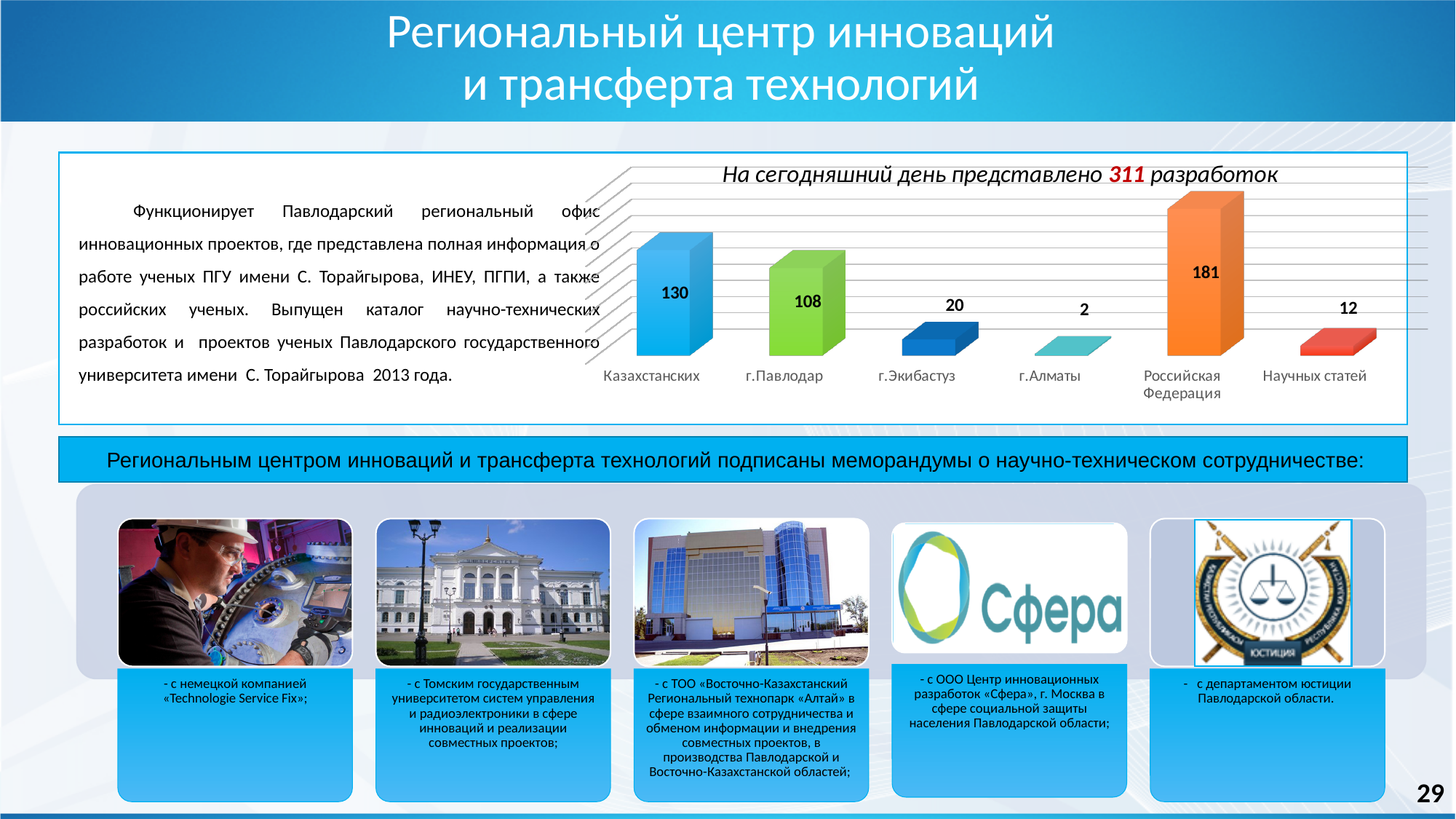
How many categories are shown in the chart? 6 What value is shown for Научных статей? 12 What is the difference between the values for Российская Федерация and Казахстанских? 51 Which is larger, the value for г.Экибастуз or the value for Научных статей? г.Экибастуз What kind of chart is shown on the slide? Bar chart What is the title of the chart? На сегодняшний день представлено 311 разработок What value is shown for г.Павлодар? 108 What value is shown for Российская Федерация? 181 Which category has the highest value? Российская Федерация Which category has the lowest value? г.Алматы What is the difference between the values for Казахстанских and г.Павлодар? 22 What value is shown for г.Алматы? 2